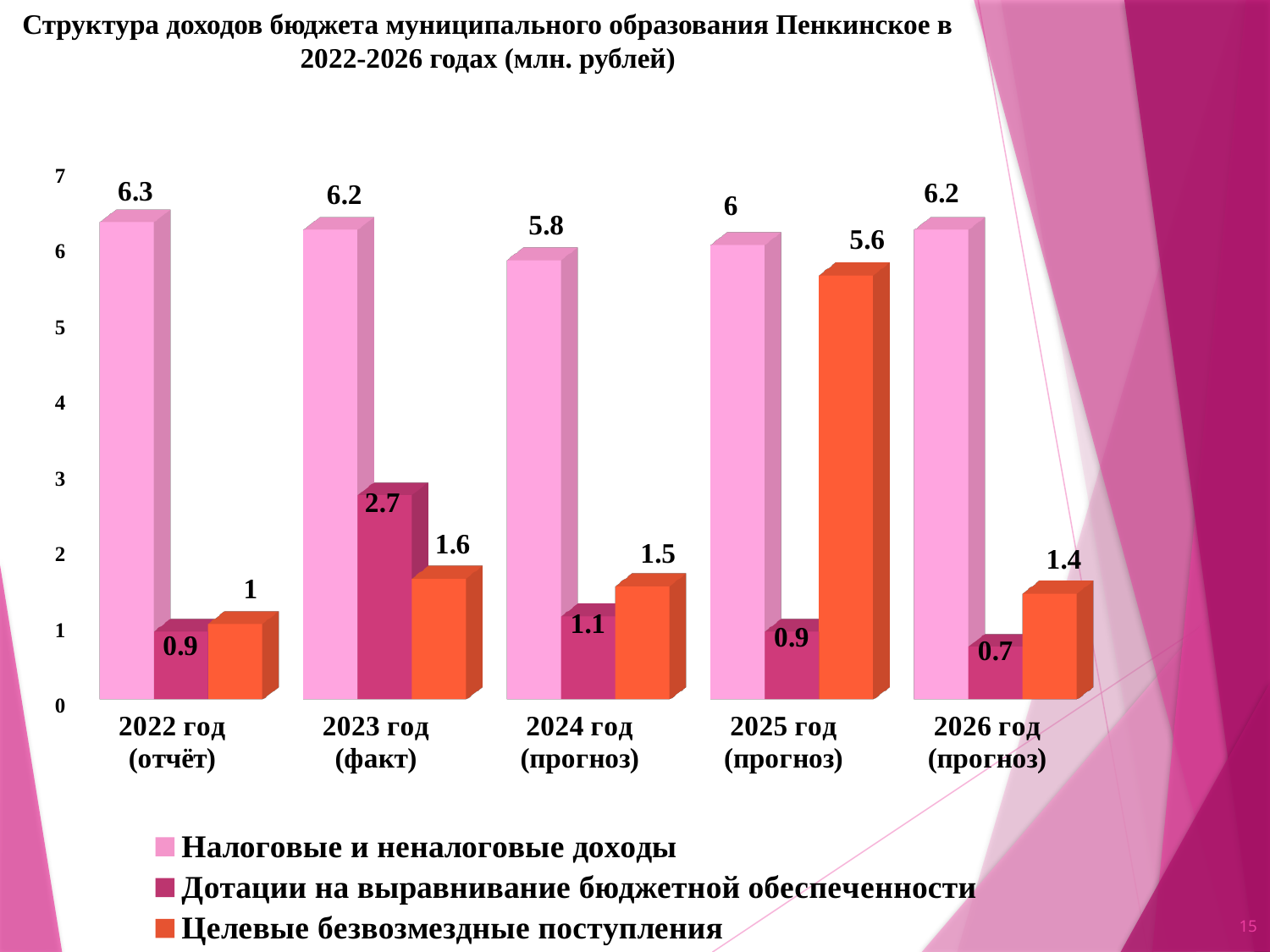
In which year is Дотации на выравнивание бюджетной обеспеченности the highest? 2023 год (факт) How many years (categories) are shown on the x axis? 5 In which year is Налоговые и неналоговые доходы the lowest? 2024 год (прогноз) What is the value of Дотации на выравнивание бюджетной обеспеченности for 2023 год (факт)? 2.7 How many series does the legend list? 3 What is the difference between Налоговые и неналоговые доходы and Целевые безвозмездные поступления in 2025 год (прогноз)? 0.4 What is the value of Целевые безвозмездные поступления for 2025 год (прогноз)? 5.6 Which is larger in 2024 год (прогноз): Дотации на выравнивание бюджетной обеспеченности or Целевые безвозмездные поступления? Целевые безвозмездные поступления What kind of chart is shown on the slide? Bar chart What is the total of the three series for 2022 год (отчёт)? 8.2 What is the value of Целевые безвозмездные поступления for 2026 год (прогноз)? 1.4 What is the value of Налоговые и неналоговые доходы for 2022 год (отчёт)? 6.3